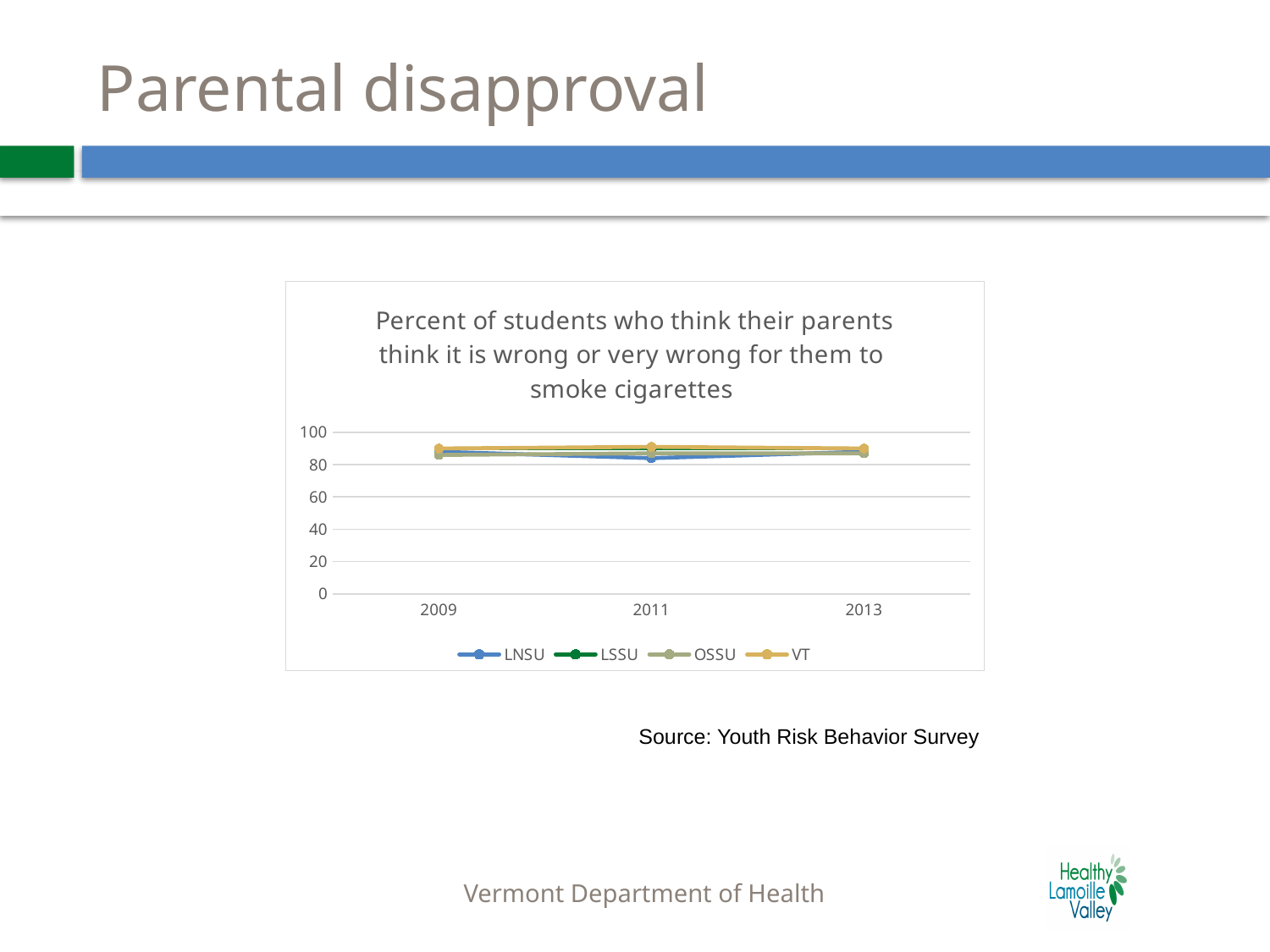
What is the title of the chart? Percent of students who think their parents think it is wrong or very wrong for them to smoke cigarettes Is the value for VT in 2011 greater or less than 60? greater What is the highest value shown on the y axis? 100 Is the value for OSSU in 2009 greater or less than 60? greater What is the first year shown on the x axis? 2009 Is the value for LNSU in 2011 greater or less than 100? less What kind of chart is shown on the slide? line chart How many years are shown on the x axis? 3 Which series are listed in the legend? LNSU, LSSU, OSSU, VT How many series does the legend list? 4